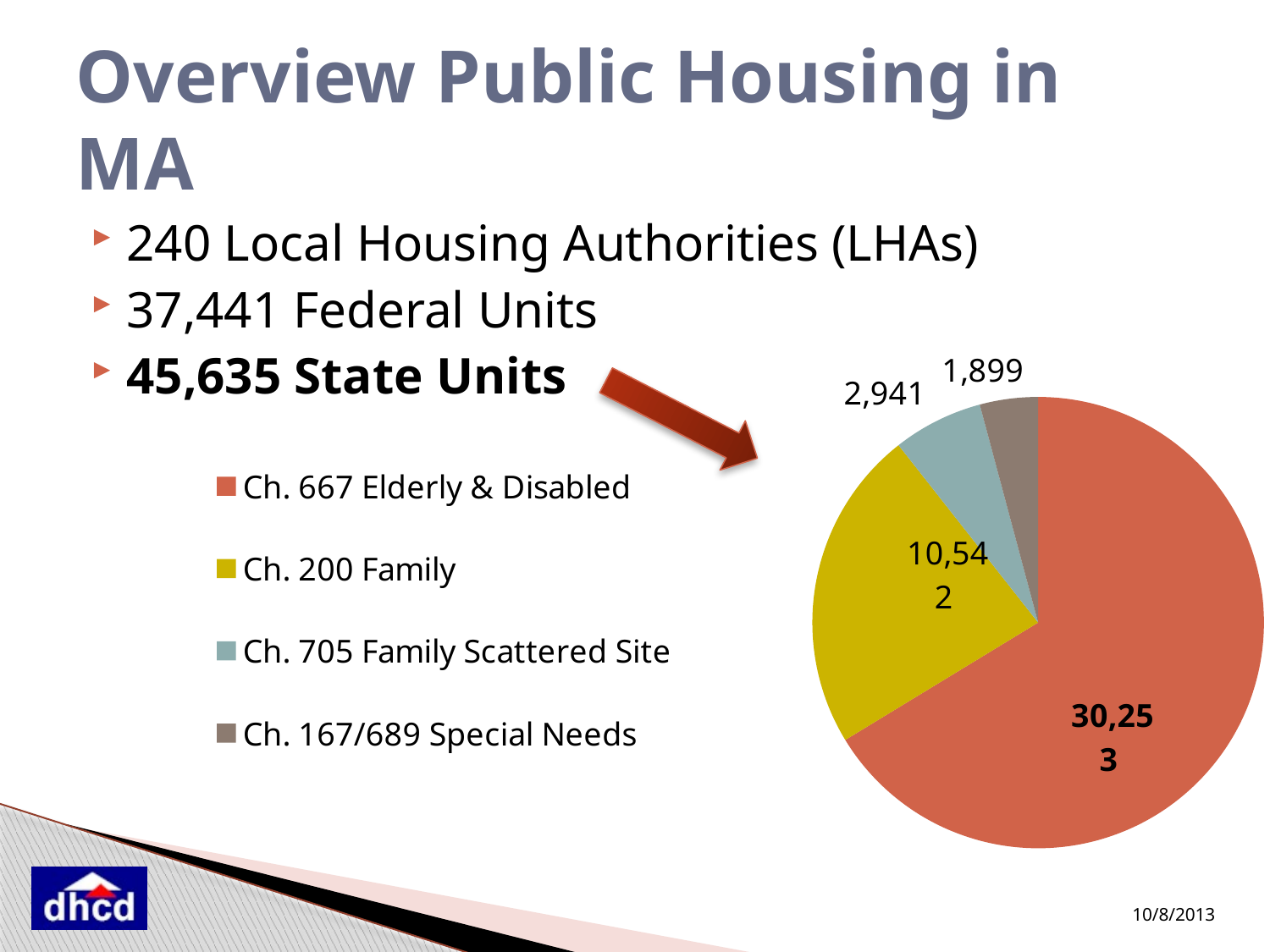
Which category has the smallest slice in the pie chart? Ch. 167/689 Special Needs How many entries does the pie chart's legend list? 4 What kind of chart is shown on the slide? Pie chart Which category has the largest slice in the pie chart? Ch. 667 Elderly & Disabled What is the value for Ch. 167/689 Special Needs in the pie chart? 1,899 What is the value for Ch. 667 Elderly & Disabled in the pie chart? 30,253 How many slices does the pie chart have? 4 What is the difference between the values for Ch. 667 Elderly & Disabled and Ch. 200 Family? 19,711 What is the value for Ch. 200 Family in the pie chart? 10,542 What is the value for Ch. 705 Family Scattered Site in the pie chart? 2,941 Which is larger in the pie chart: Ch. 705 Family Scattered Site or Ch. 167/689 Special Needs? Ch. 705 Family Scattered Site What colour is the Ch. 200 Family slice in the pie chart? Yellow